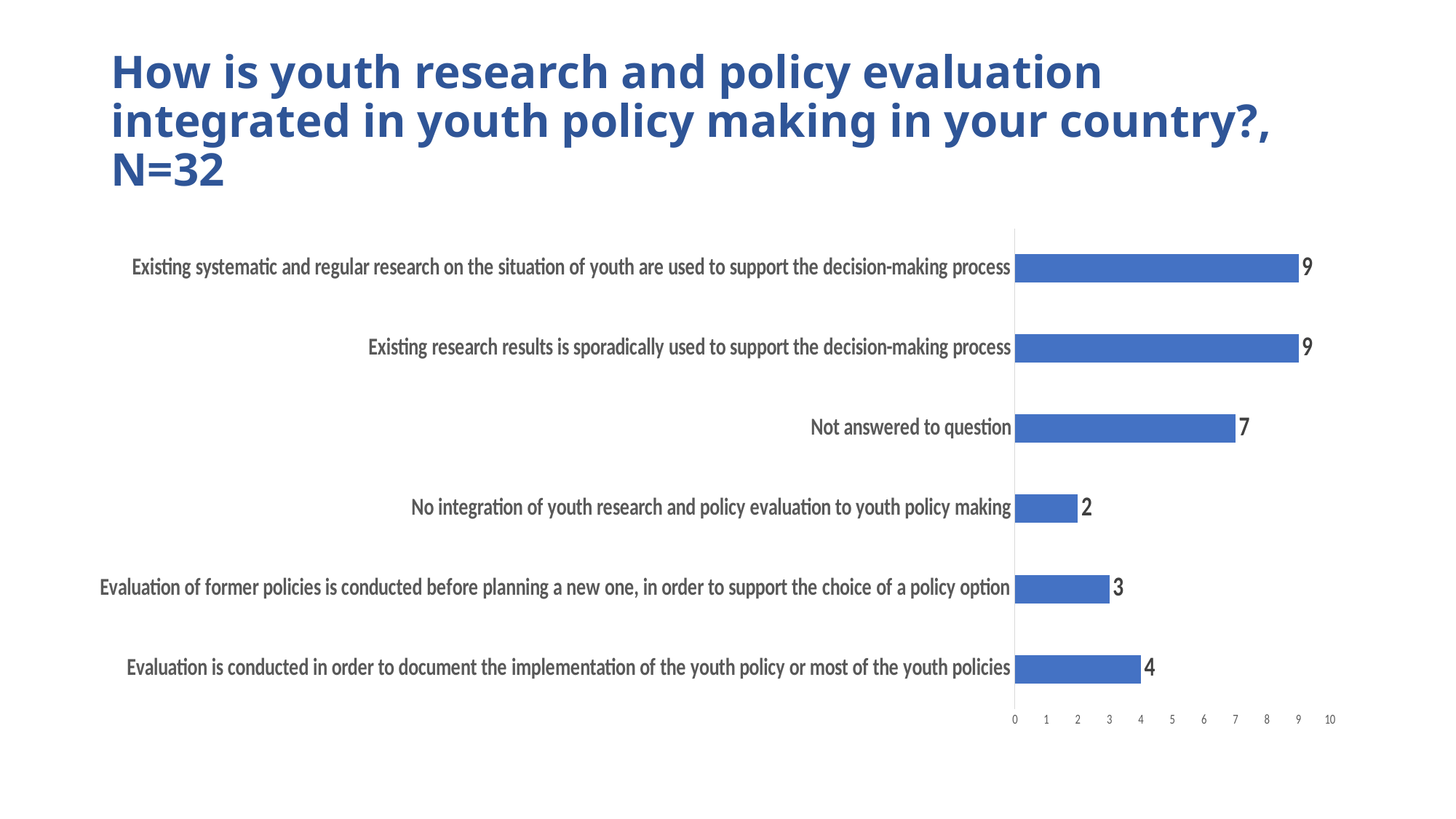
What is the value for "Not answered to question"? 7 What is the difference between the values for "Not answered to question" and "No integration of youth research and policy evaluation to youth policy making"? 5 Which is larger: the value for "Not answered to question" or the value for "Evaluation is conducted in order to document the implementation of the youth policy or most of the youth policies"? Not answered to question What is the value for "No integration of youth research and policy evaluation to youth policy making"? 2 What is the total of the values for "Existing systematic and regular research on the situation of youth are used to support the decision-making process" and "Existing research results is sporadically used to support the decision-making process"? 18 What is the value for "Evaluation of former policies is conducted before planning a new one, in order to support the choice of a policy option"? 3 What is the highest value shown on the x axis? 10 Which category has the lowest value? No integration of youth research and policy evaluation to youth policy making What kind of chart is shown on the slide? Bar chart What is the value for "Existing research results is sporadically used to support the decision-making process"? 9 What is the value for "Evaluation is conducted in order to document the implementation of the youth policy or most of the youth policies"? 4 How many categories are shown in the chart? 6